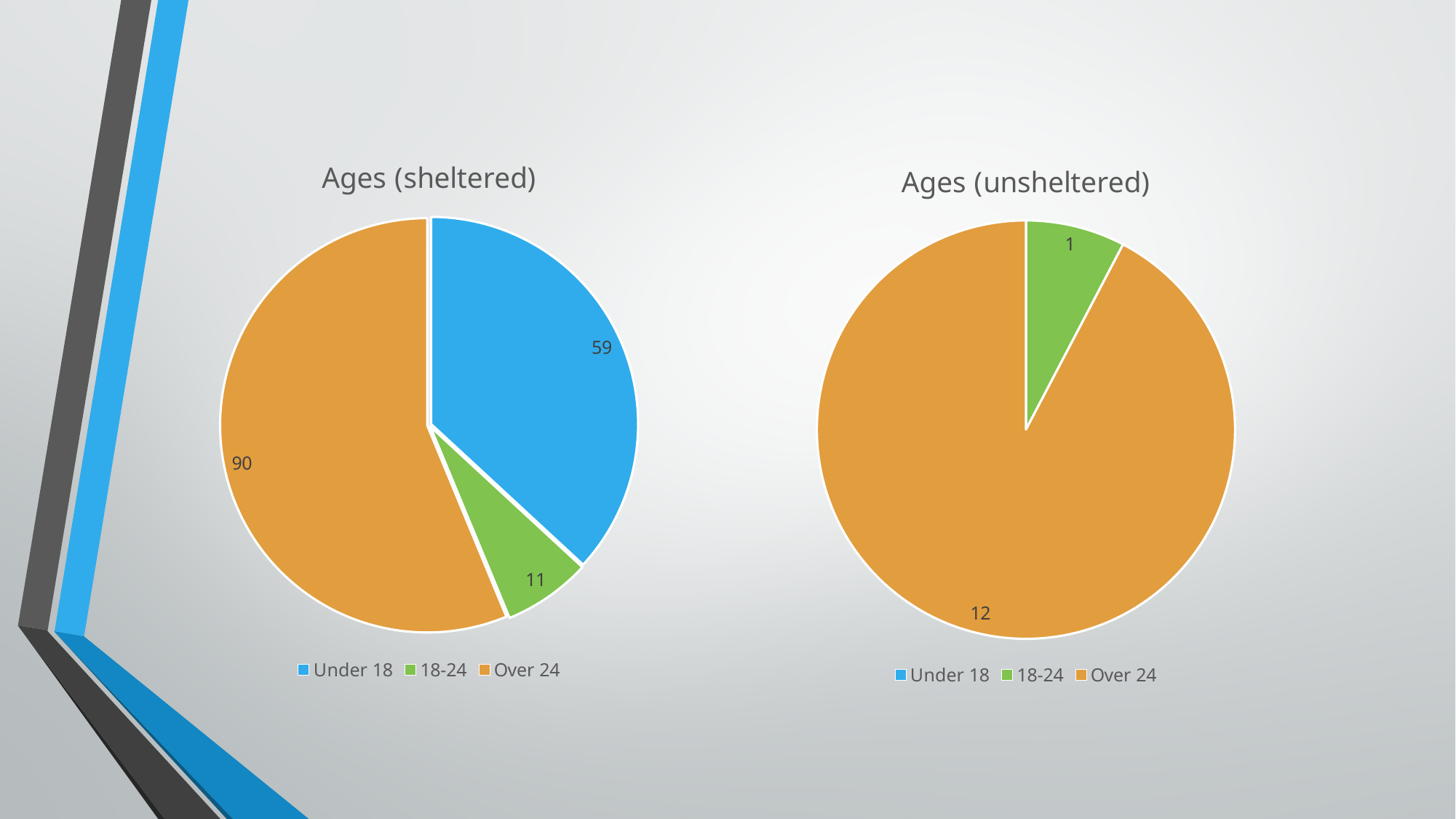
In the Ages (unsheltered) chart, what is the difference between the Over 24 and 18-24 values? 11 What type of chart is Ages (unsheltered)? Pie chart In the Ages (sheltered) chart, what is the difference between the Over 24 and Under 18 values? 31 In the Ages (sheltered) chart, which is larger, Under 18 or 18-24? Under 18 In the Ages (sheltered) chart, what is the value for 18-24? 11 In the Ages (sheltered) chart, what is the value for Under 18? 59 In the Ages (sheltered) chart, what is the value for Over 24? 90 In the Ages (unsheltered) chart, what is the value for Over 24? 12 In the Ages (unsheltered) chart, what is the value for 18-24? 1 In the Ages (sheltered) chart, which age group has the smallest slice? 18-24 In the Ages (sheltered) chart, which age group has the largest slice? Over 24 How many entries does the legend of the Ages (sheltered) chart list? 3